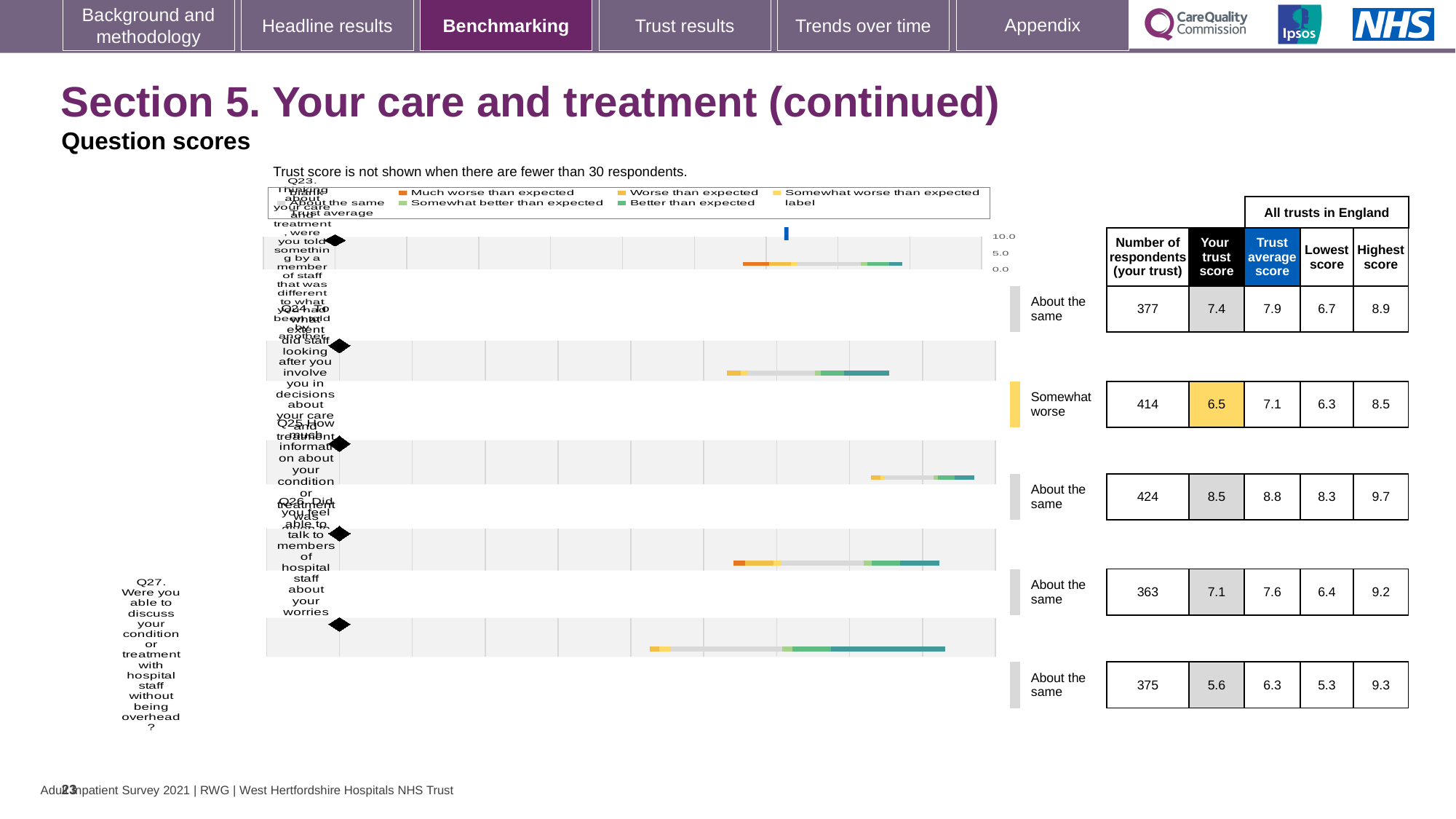
How many respondents answered Q25 (the third row of the chart) at this trust? 424 What is the lowest score across all trusts in England for Q27 (the bottom row)? 5.3 What is the trust average score for Q27 (the bottom row of the chart)? 6.3 How many question rows are shown in the chart? 5 What is the difference between the trust average score and this trust's score for Q23 (the top row)? 0.5 What colour does the legend use for 'Much worse than expected'? Orange Which question row is rated 'Somewhat worse' rather than 'About the same'? Q24 What is the trust score for Q24 (the second row of the chart)? 6.5 Which question row has the highest 'Your trust score'? Q25 Which is larger for Q27: the trust's own score or the trust average score? Trust average score Which question row has the lowest 'Your trust score'? Q27 What is the highest score across all trusts in England for Q26 (the fourth row of the chart)? 9.2